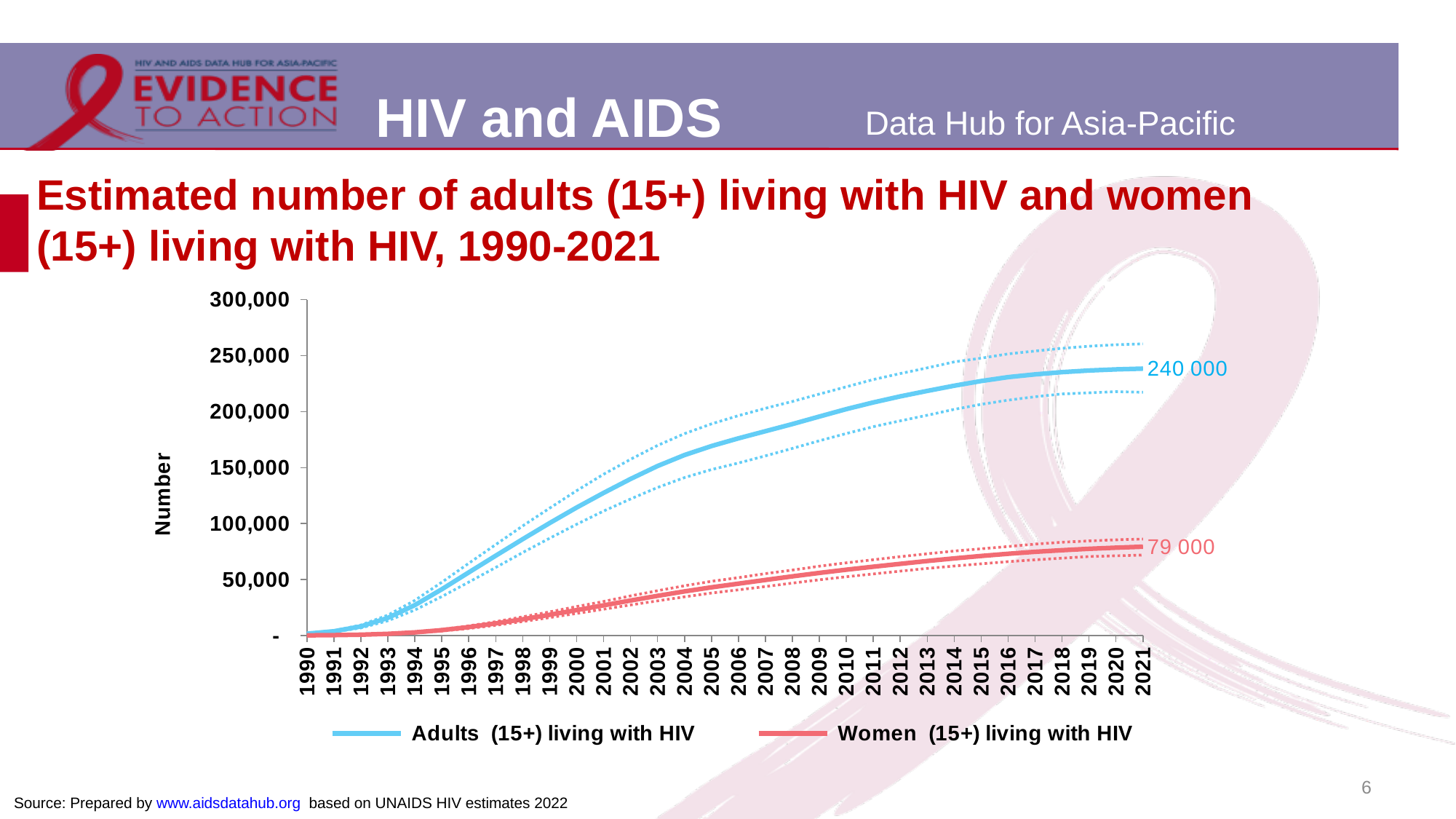
In 2021, which series has the larger value: Adults (15+) living with HIV or Women (15+) living with HIV? Adults (15+) living with HIV What is the difference between the 2021 values for Adults (15+) living with HIV and Women (15+) living with HIV? 161 000 Is the value for Adults (15+) living with HIV in 2010 greater or less than 150,000? greater What is the labelled value for Women (15+) living with HIV in 2021? 79 000 Is the value for Adults (15+) living with HIV in 1998 greater or less than 100,000? less How many series does the legend list? 2 What is the labelled value for Adults (15+) living with HIV in 2021? 240 000 Is the value for Women (15+) living with HIV in 2005 greater or less than 50,000? less Do the values for Adults (15+) living with HIV rise or fall from 1990 to 2021? rise What kind of chart is shown on the slide? line chart What is the title of the vertical axis? Number How many years are shown on the x axis of the chart? 32